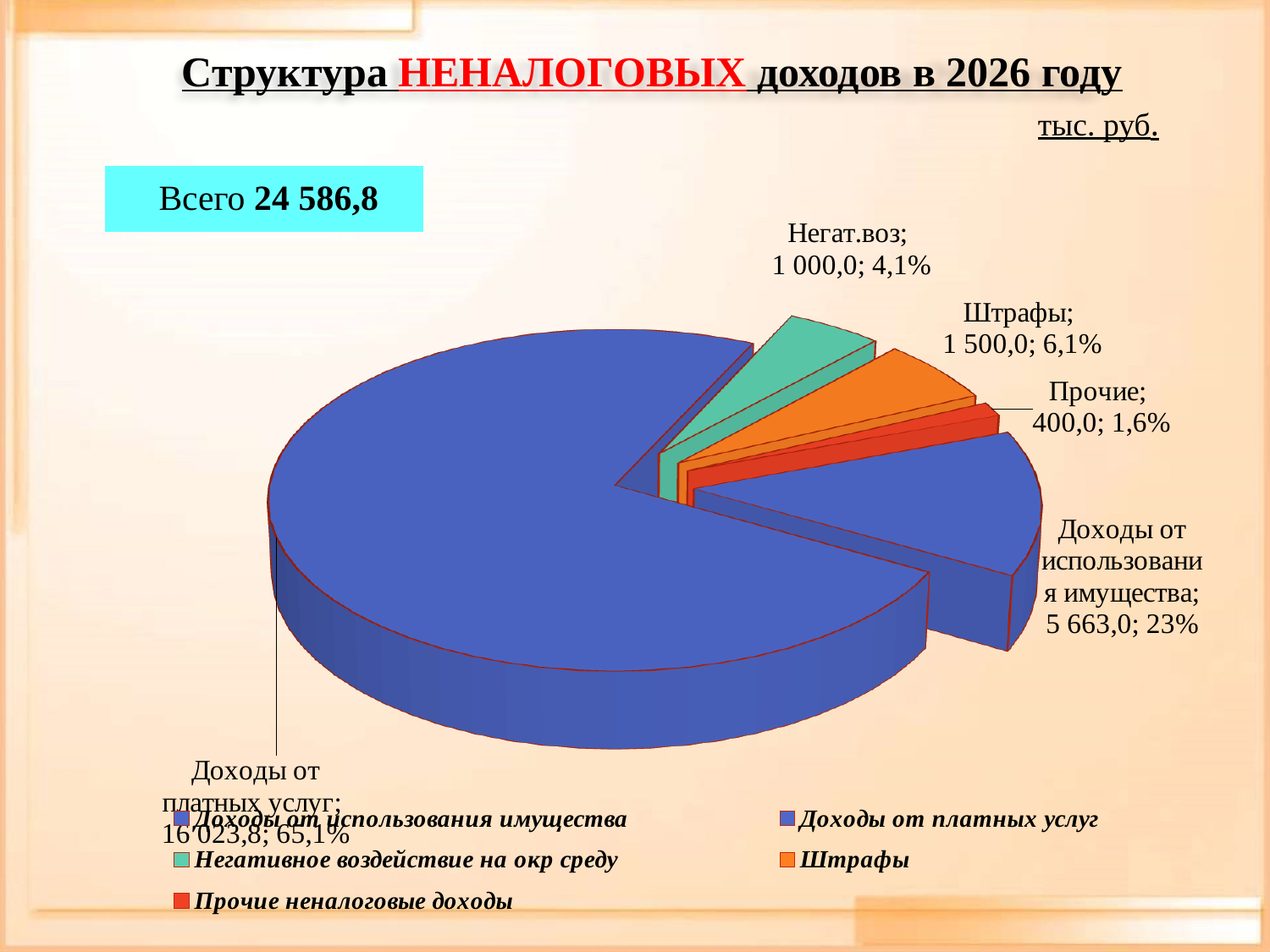
Which category has the smallest slice? Прочие What is the value for Доходы от использования имущества? 5 663,0 Which category has the largest slice? Доходы от платных услуг What share of the pie does Негат.воз represent? 4,1% How many slices does the pie chart have? 5 What is the value for Доходы от платных услуг? 16 023,8 Which is larger, the value for Доходы от использования имущества or the value for Штрафы? Доходы от использования имущества What kind of chart is shown on the slide? pie chart What is the value for Штрафы? 1 500,0 What is the difference between the values for Штрафы and Негат.воз? 500,0 What total value (Всего) is shown on the slide? 24 586,8 What share of the pie does Прочие represent? 1,6%